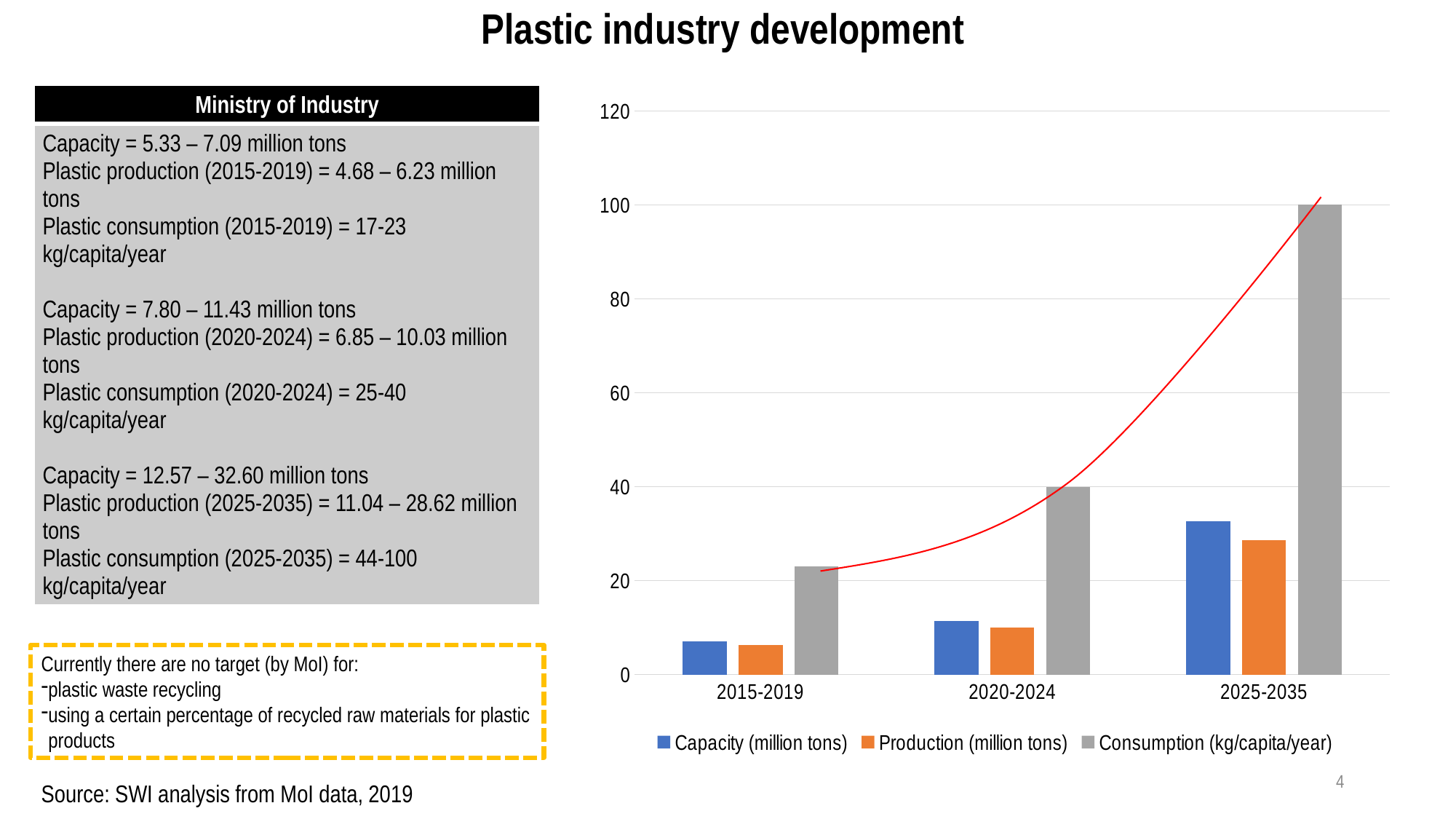
Which period has the highest Consumption (kg/capita/year) value? 2025-2035 What is the Consumption (kg/capita/year) value for 2025-2035? 100 Is the Capacity (million tons) value for 2025-2035 greater or less than 20? greater How many period categories are shown on the x axis of the chart? 3 In 2025-2035, which is larger: Capacity (million tons) or Production (million tons)? Capacity (million tons) What is the Consumption (kg/capita/year) value for 2020-2024? 40 How many series does the chart legend list? 3 What is the difference in Consumption (kg/capita/year) between 2025-2035 and 2020-2024? 60 Does the Consumption (kg/capita/year) series rise or fall across the periods from 2015-2019 to 2025-2035? Rise Is the Production (million tons) value for 2025-2035 greater or less than 40? less What type of chart is shown on the slide? Bar chart Which period has the lowest Capacity (million tons) value? 2015-2019